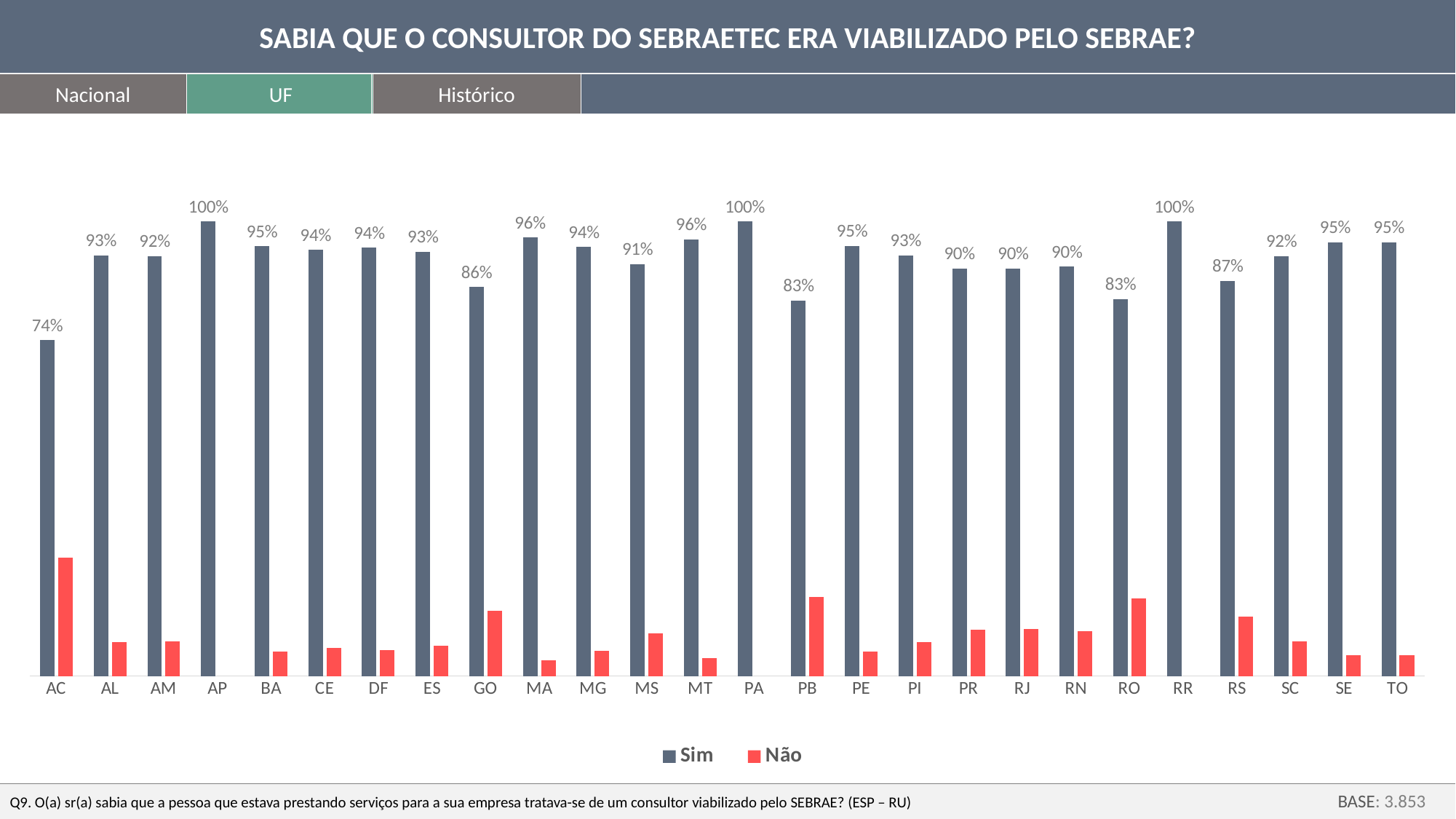
What is the "Sim" value for GO? 86% How many states (categories) are shown on the x axis? 26 Which has a higher "Sim" value, GO or RO? GO Which state has the lowest "Sim" value? AC How many states show a "Sim" value of 100%? 3 How many series does the legend list? 2 What type of chart is shown on the slide? Bar chart What is the difference between the "Sim" values for AL and AC? 19 percentage points What is the "Sim" value for RS? 87% What is the "Sim" value for AC? 74% What is the "Sim" value for PB? 83% What is the difference between the "Sim" values for MA and GO? 10 percentage points